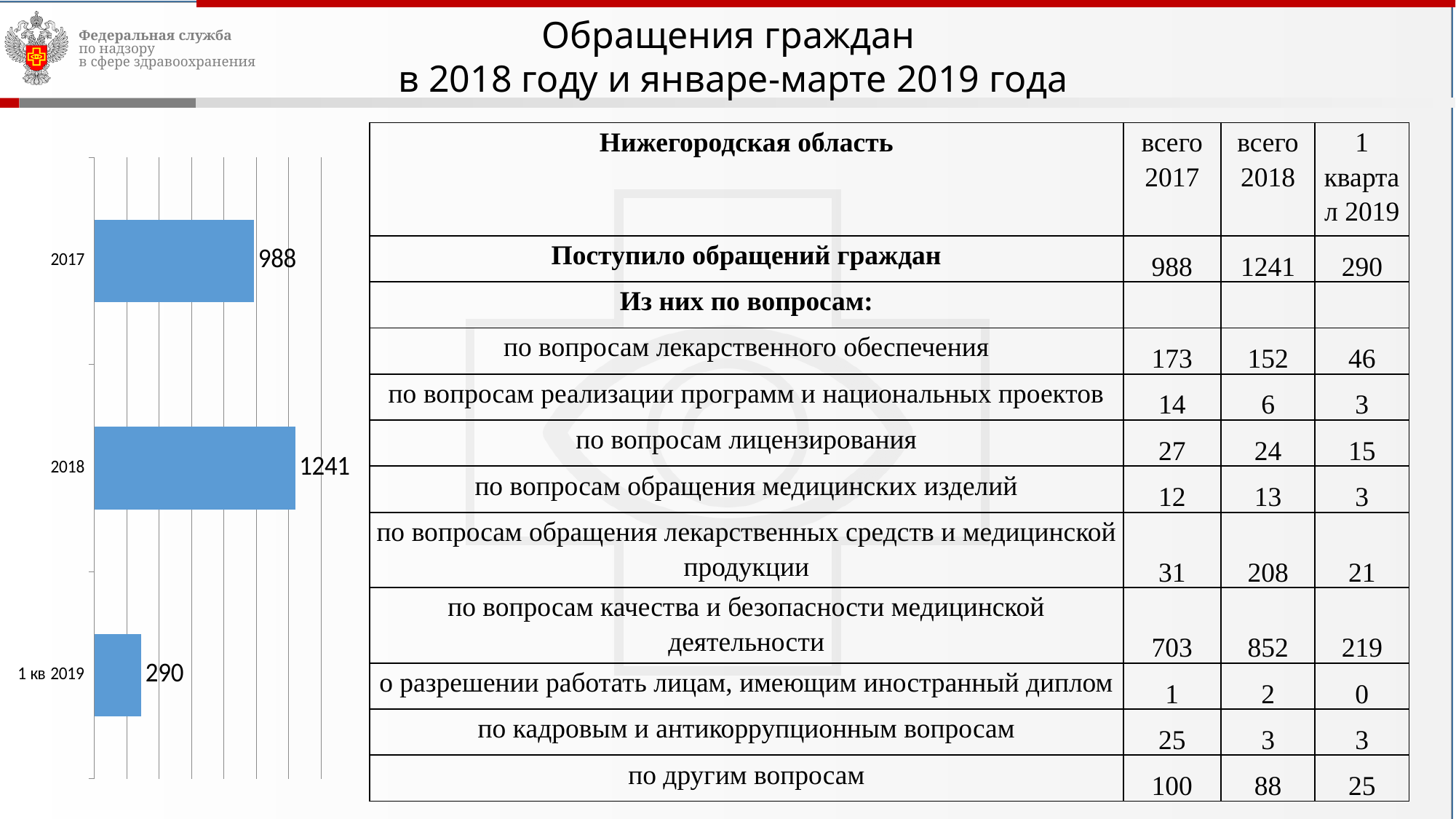
Does the value rise or fall from 2017 to 2018 in the bar chart? Rise How many categories are plotted in the bar chart? 3 What kind of chart is shown on the left of the slide? Bar chart Which category has the lowest value in the bar chart? 1 кв 2019 What is the value shown for 1 кв 2019 in the bar chart? 290 What is the difference between the values for 2018 and 2017 in the bar chart? 253 What colour are the bars in the chart? Blue What is the value shown for 2017 in the bar chart? 988 Which category has the highest value in the bar chart? 2018 What is the difference between the values for 2017 and 1 кв 2019 in the bar chart? 698 What is the value shown for 2018 in the bar chart? 1241 Which is larger in the bar chart, the value for 2017 or the value for 2018? 2018